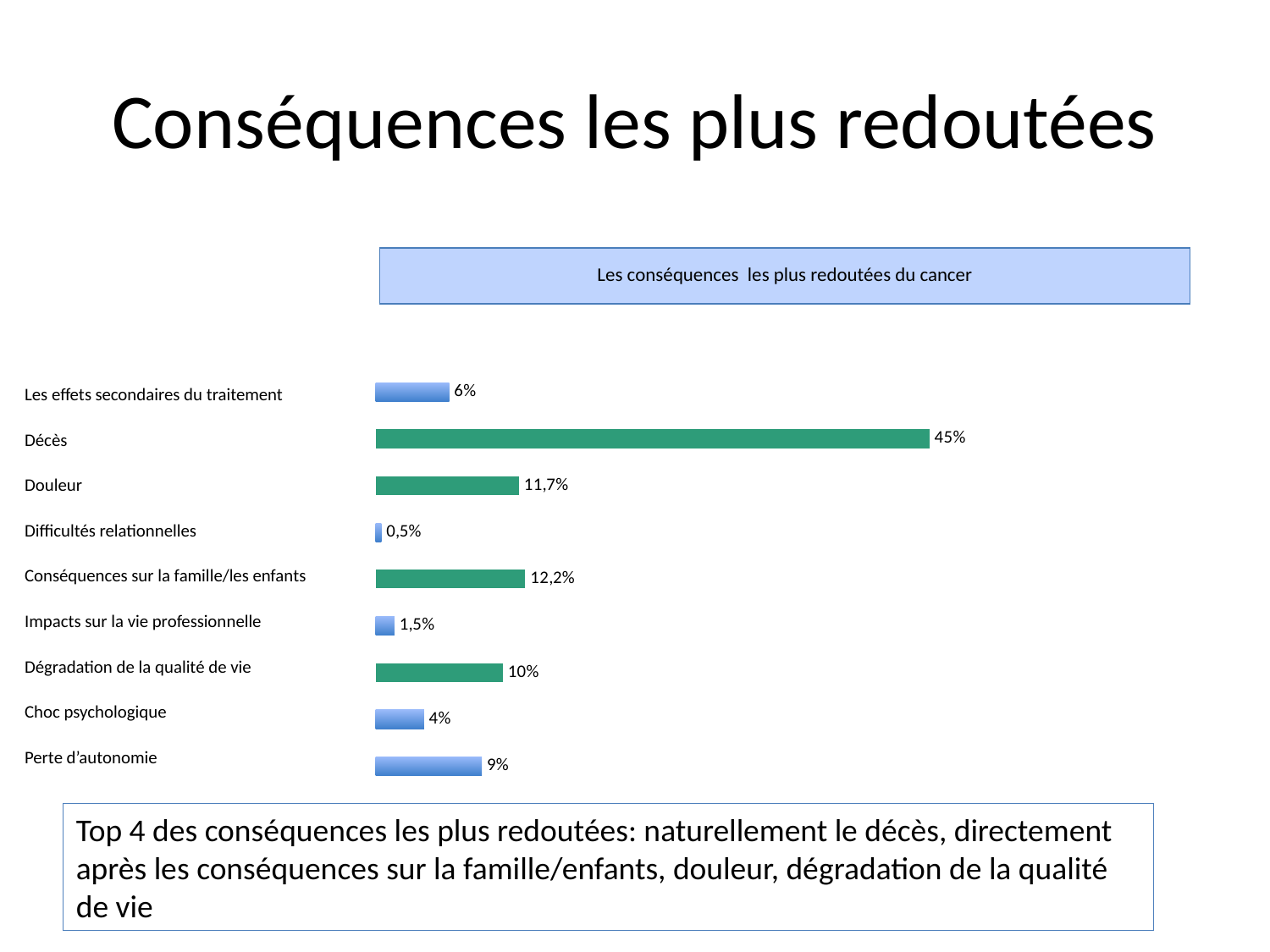
What is the value for Douleur? 11,7% What is the value for Perte d'autonomie? 9% What is the difference between the values for Dégradation de la qualité de vie and Choc psychologique? 6% Which is larger, the value for Conséquences sur la famille/les enfants or the value for Douleur? Conséquences sur la famille/les enfants How many categories are shown in the chart? 9 What is the difference between the values for Décès and Douleur? 33,3% What kind of chart is shown on the slide? Bar chart What is the value for Décès? 45% Which category has the highest value? Décès Which category has the lowest value? Difficultés relationnelles What is the value for Conséquences sur la famille/les enfants? 12,2% What is the title of the chart? Les conséquences les plus redoutées du cancer